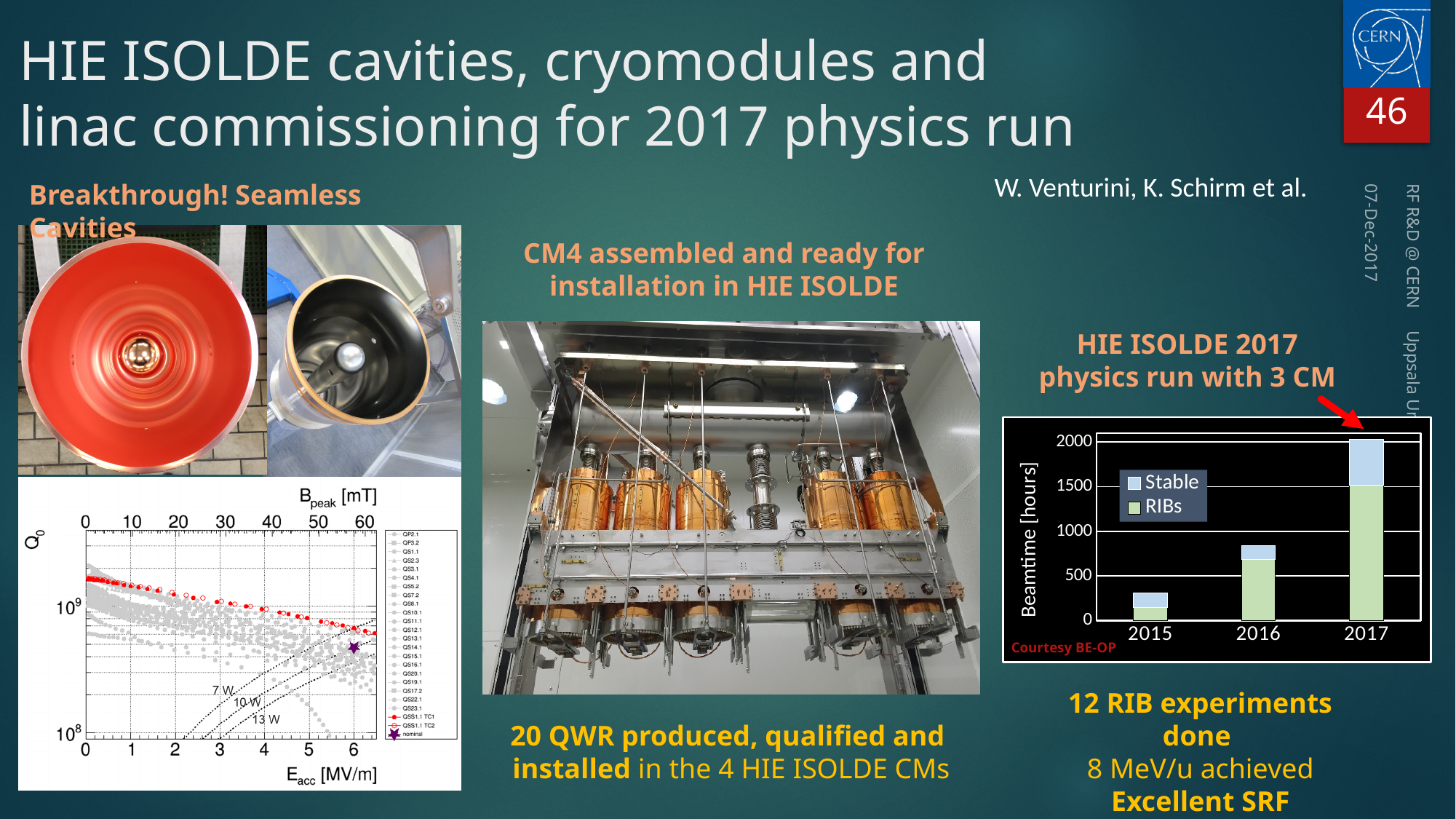
How many series does the legend of the 'Beamtime [hours]' bar chart list? 2 In the 'Beamtime [hours]' bar chart, does total beamtime rise or fall from 2015 to 2017? rise What kind of chart is the Q0 versus Eacc plot at the bottom left of the slide? scatter plot In the 'Beamtime [hours]' bar chart, is the total beamtime for 2017 greater or less than 1500? greater How many years are shown on the x axis of the 'Beamtime [hours]' bar chart? 3 Which series are listed in the legend of the 'Beamtime [hours]' bar chart? Stable and RIBs In the 'Beamtime [hours]' bar chart, which year has the highest total beamtime? 2017 In the 'Beamtime [hours]' bar chart, which year has the lowest total beamtime? 2015 In the 'Beamtime [hours]' bar chart, is the total beamtime for 2016 greater or less than 1000? less What kind of chart is the 'Beamtime [hours]' chart on the right of the slide? stacked bar chart In the 'Beamtime [hours]' bar chart, is the total beamtime for 2015 greater or less than 500? less